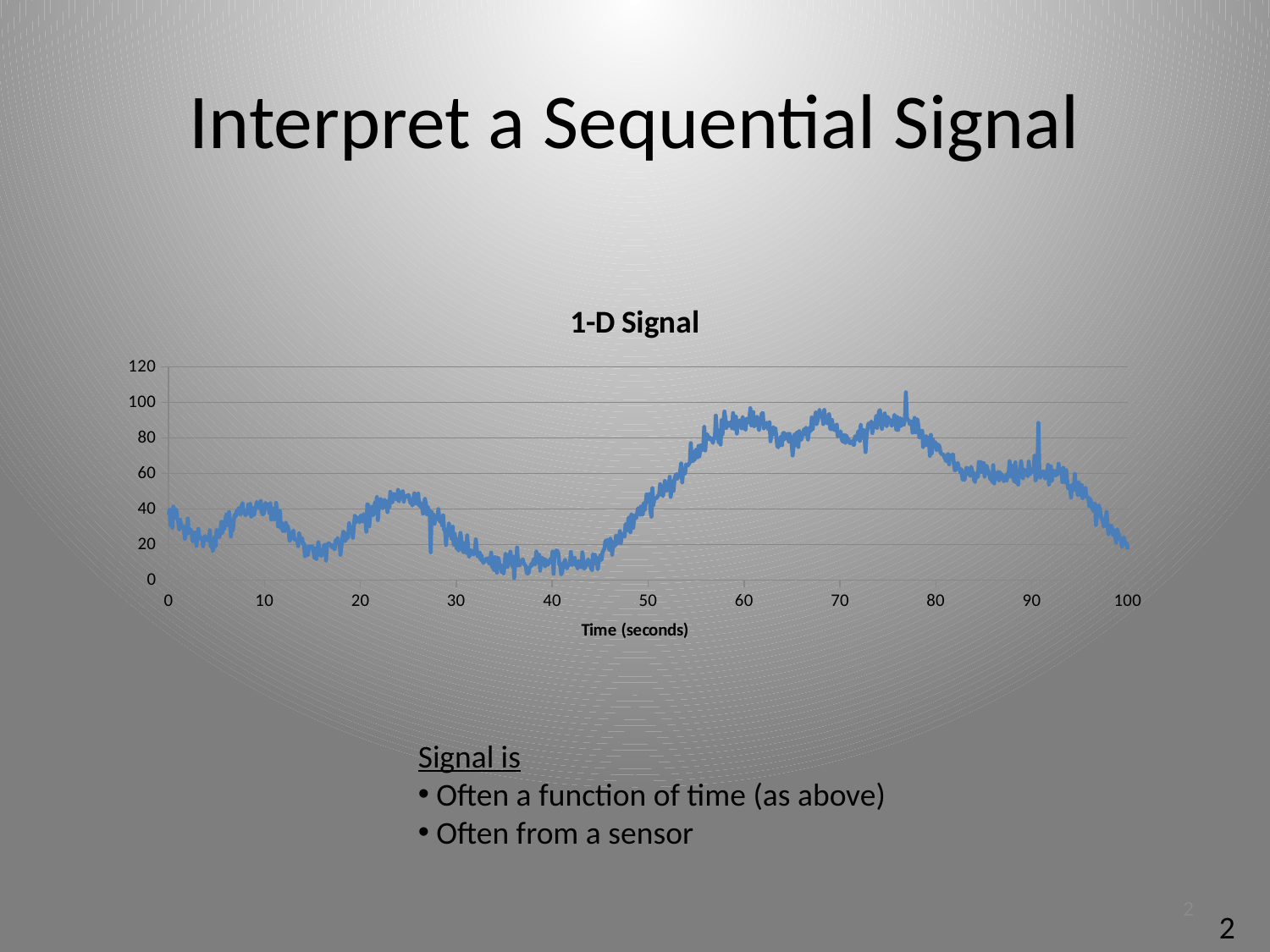
Is the value of the signal at 60 seconds greater or less than 80? greater What is the highest value shown on the y axis of the chart? 120 What is the title of the chart? 1-D Signal What is the label of the x axis of the chart? Time (seconds) Does the signal rise or fall between 45 and 58 seconds? rise Is the value of the signal at 40 seconds greater or less than 20? less Is the signal at 60 seconds higher or lower than at 40 seconds? higher Is the value of the signal at 100 seconds greater or less than 40? less Does the signal rise or fall between 90 and 100 seconds? fall What kind of chart is shown on the slide? line chart